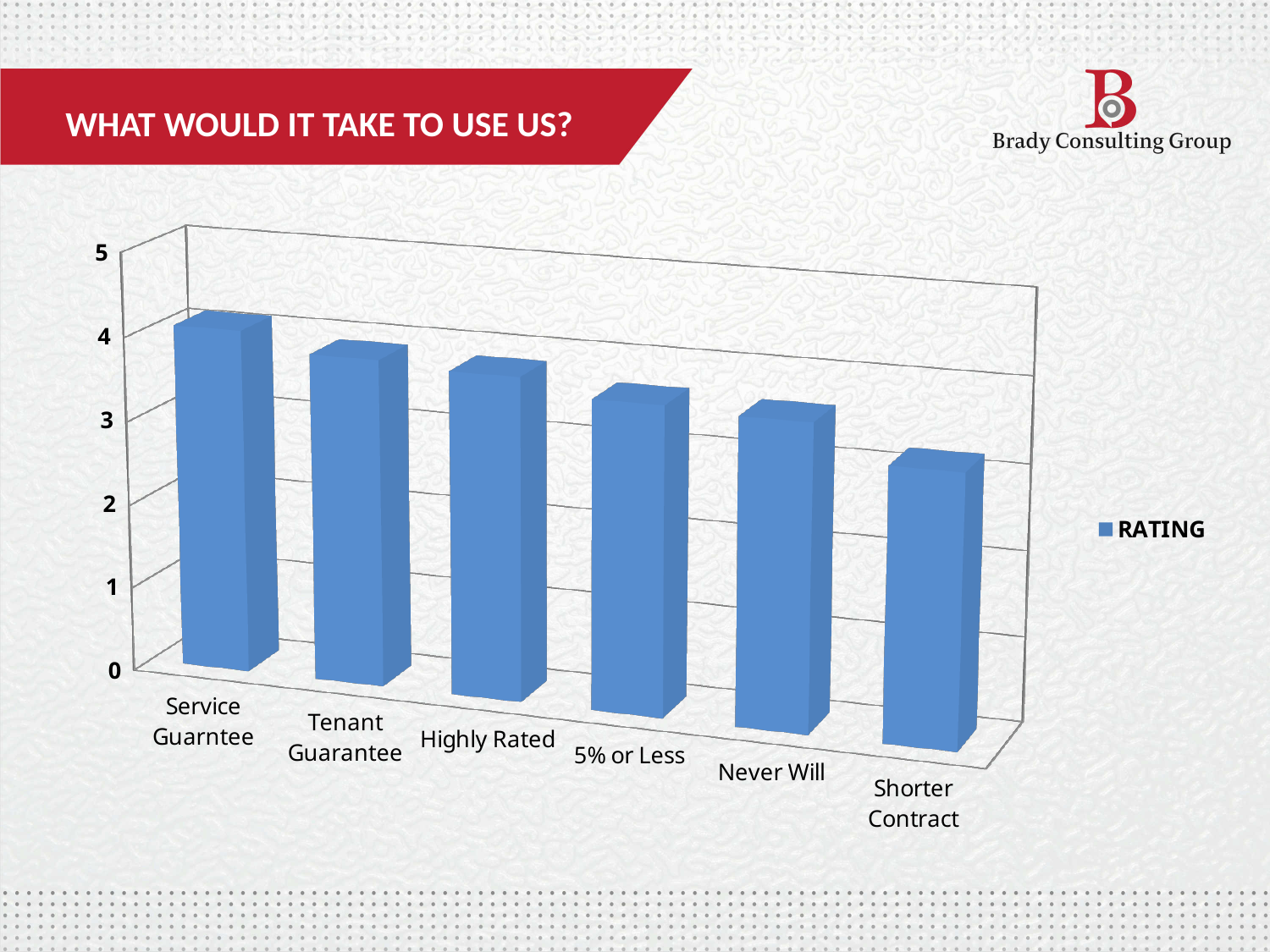
Which category has the highest rating? Service Guarntee Which has a higher rating, Tenant Guarantee or Never Will? Tenant Guarantee How many categories are shown on the x axis of the chart? 6 How many series does the chart legend list? 1 Is the rating for Service Guarntee greater or less than 3? greater Is the rating for Shorter Contract greater or less than 1? greater Is the rating for Never Will greater or less than 4? less Do the ratings rise or fall moving from left to right across the categories? fall Which has a higher rating, Service Guarntee or Shorter Contract? Service Guarntee What is the name of the series shown in the chart legend? RATING Which category has the lowest rating? Shorter Contract What kind of chart is shown on the slide? Bar chart